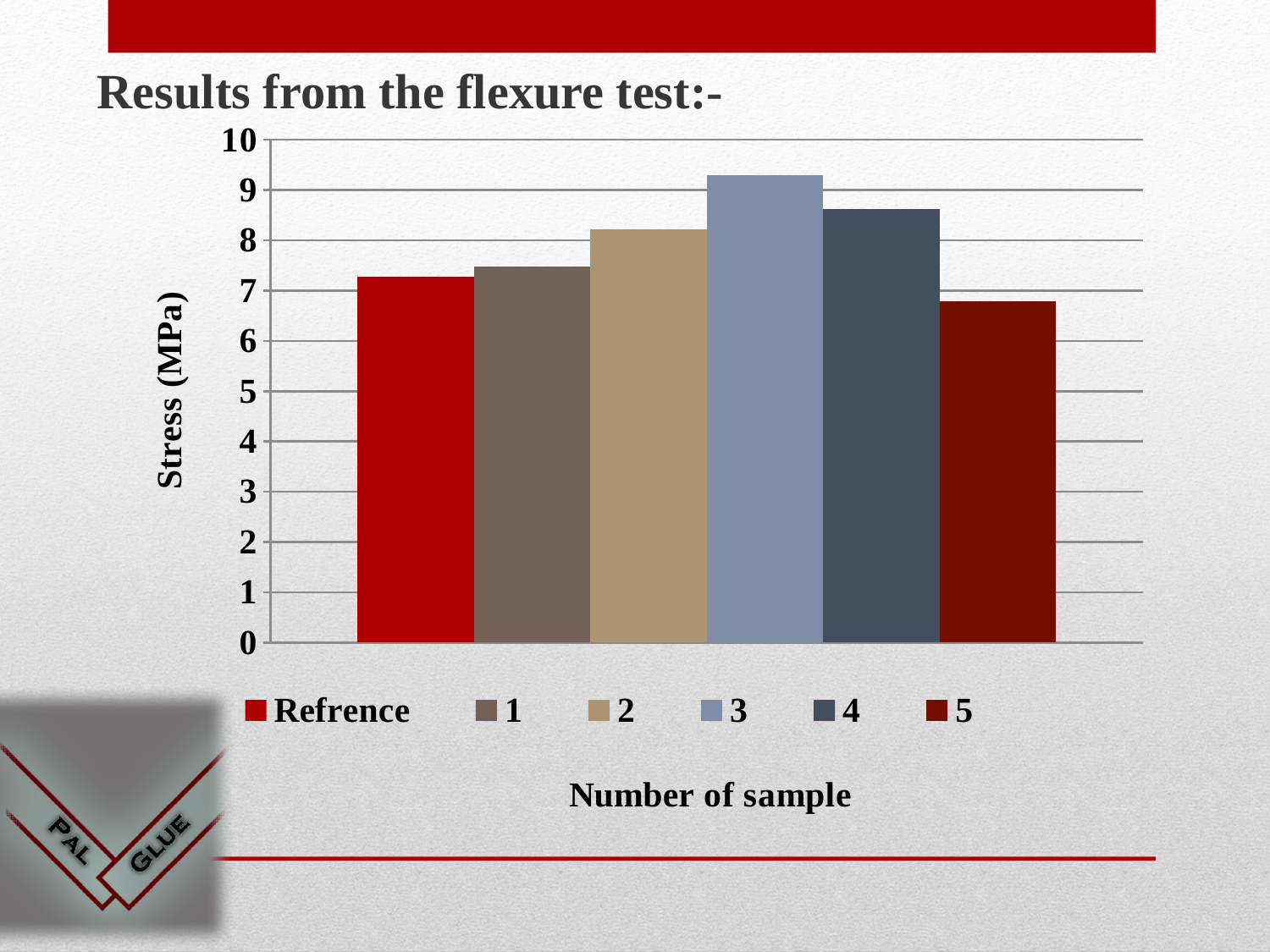
Which has a higher stress value, sample 4 or sample 5? 4 How many bars are plotted in the chart? 6 Which sample has the highest stress value? 3 What kind of chart is shown on the slide? bar chart What is the label of the vertical axis? Stress (MPa) Is the stress value for sample 2 greater or less than 8? greater Is the stress value for sample 5 greater or less than 7? less Which has a higher stress value, sample 2 or sample 1? 2 Which sample has the lowest stress value? 5 Is the stress value for Refrence greater or less than 7? greater